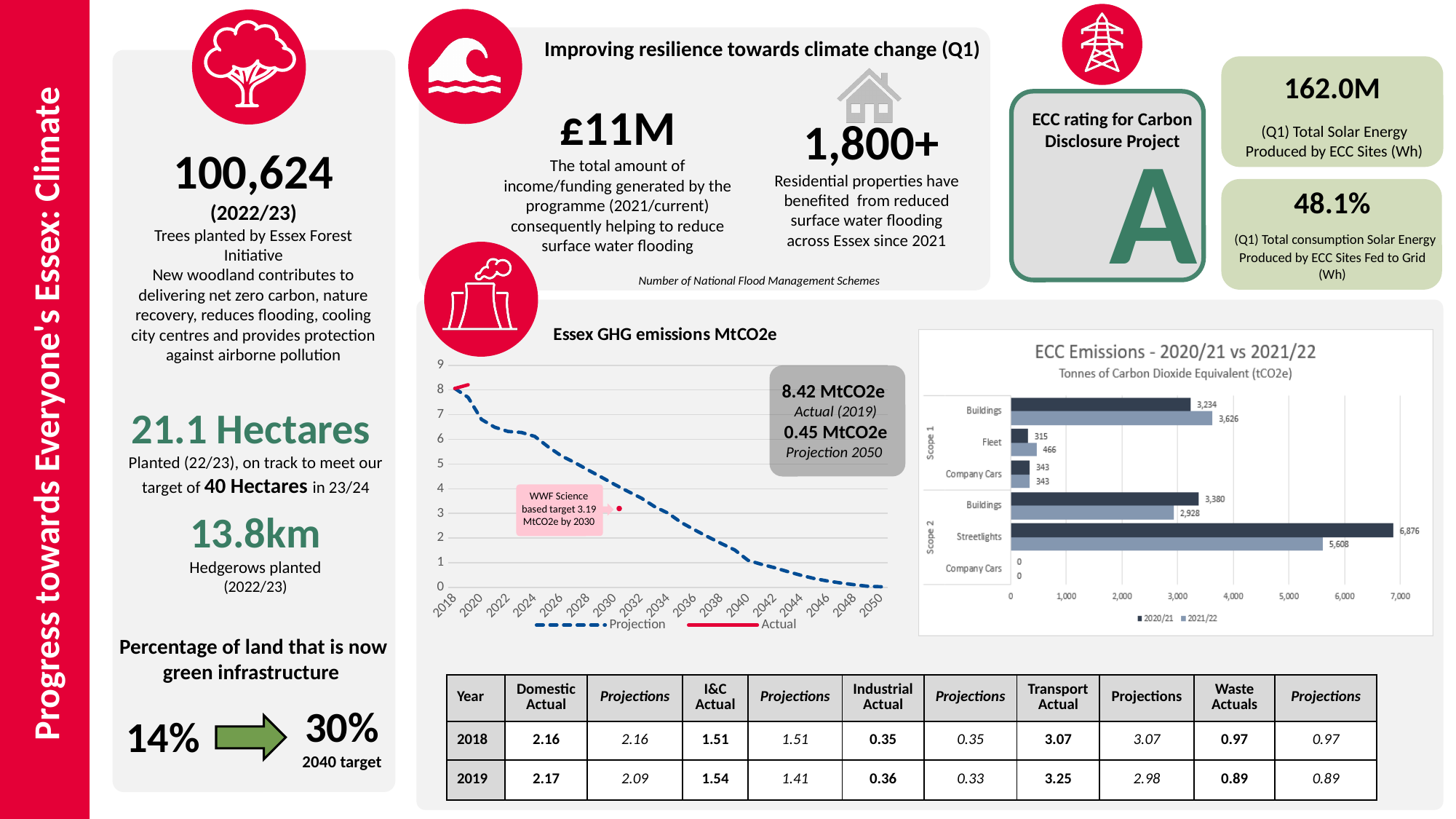
What kind of chart is the ECC Emissions - 2020/21 vs 2021/22 chart? Bar chart In the ECC Emissions - 2020/21 vs 2021/22 chart, which year has the larger value for Fleet, 2020/21 or 2021/22? 2021/22 In the ECC Emissions - 2020/21 vs 2021/22 chart, which category has the highest 2020/21 value? Streetlights In the ECC Emissions - 2020/21 vs 2021/22 chart, what is the 2021/22 value for Scope 1 Buildings? 3,626 In the ECC Emissions - 2020/21 vs 2021/22 chart, what is the 2020/21 value for Streetlights? 6,876 In the Essex GHG emissions MtCO2e chart, do the projected values rise or fall from 2018 to 2050? fall In the Essex GHG emissions MtCO2e chart, how many series does the legend list? 2 In the ECC Emissions - 2020/21 vs 2021/22 chart, how many series does the legend list? 2 In the ECC Emissions - 2020/21 vs 2021/22 chart, what is the difference between the 2020/21 and 2021/22 values for Streetlights? 1,268 In the ECC Emissions - 2020/21 vs 2021/22 chart, what is the 2021/22 value for Scope 2 Company Cars? 0 In the ECC Emissions - 2020/21 vs 2021/22 chart, is the 2021/22 value for Scope 2 Buildings greater or less than 3,000? less